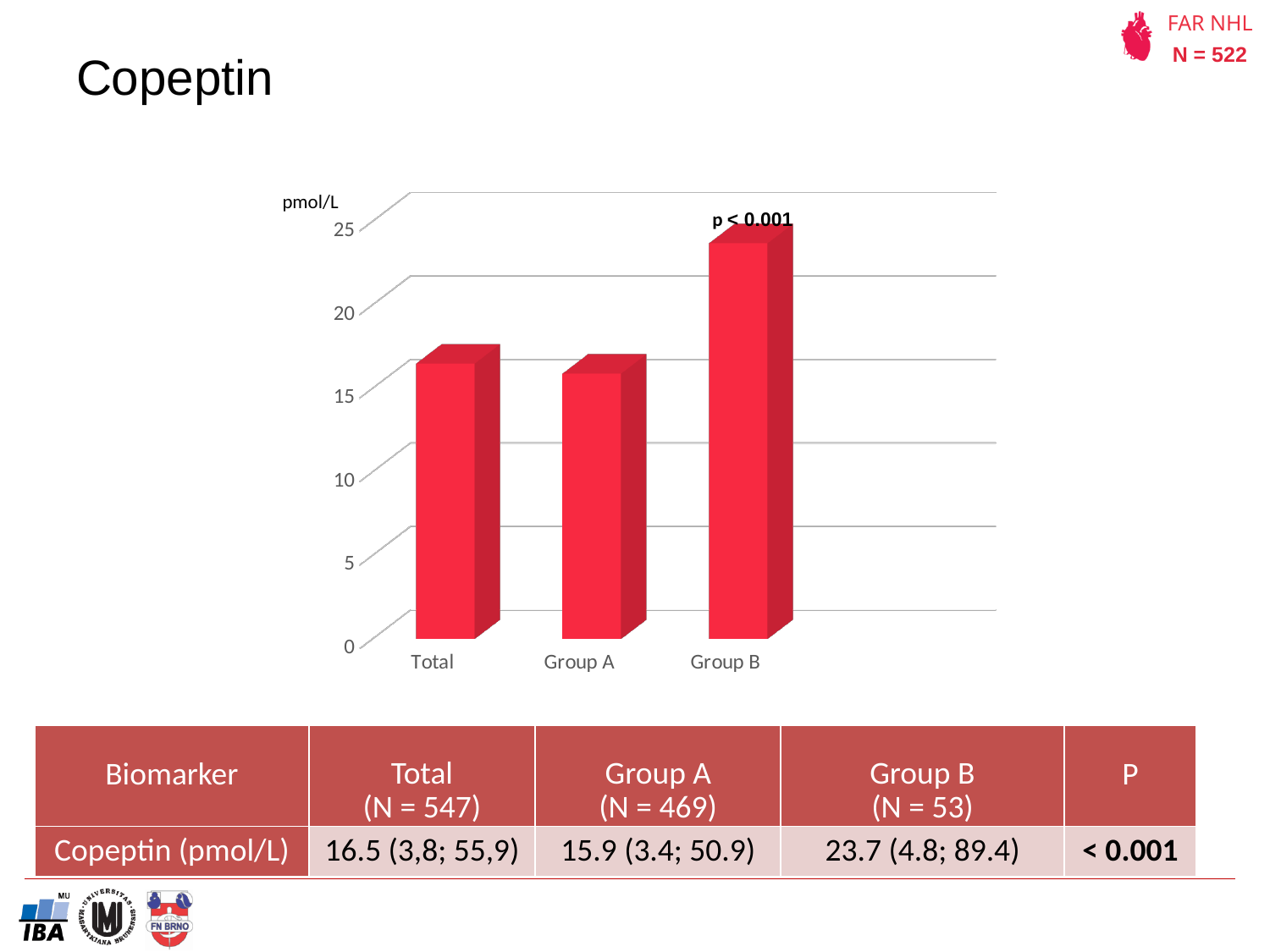
According to the table on the slide, what is the copeptin value for Group A? 15.9 Is the value for Group A greater or less than 20? less How many categories are plotted on the chart? 3 Using the values in the table, what is the difference between the copeptin value for Group B and for Group A? 7.8 Which is larger, the value for Group B or the value for Group A? Group B Is the value for Group B greater or less than 20? greater According to the table on the slide, what is the copeptin value for Group B? 23.7 What p-value annotation is printed above the Group B bar? p < 0.001 What unit is shown on the y axis of the chart? pmol/L Which category has the highest bar on the chart? Group B Is the value for Total greater or less than 15? greater What kind of chart is shown on the slide? bar chart